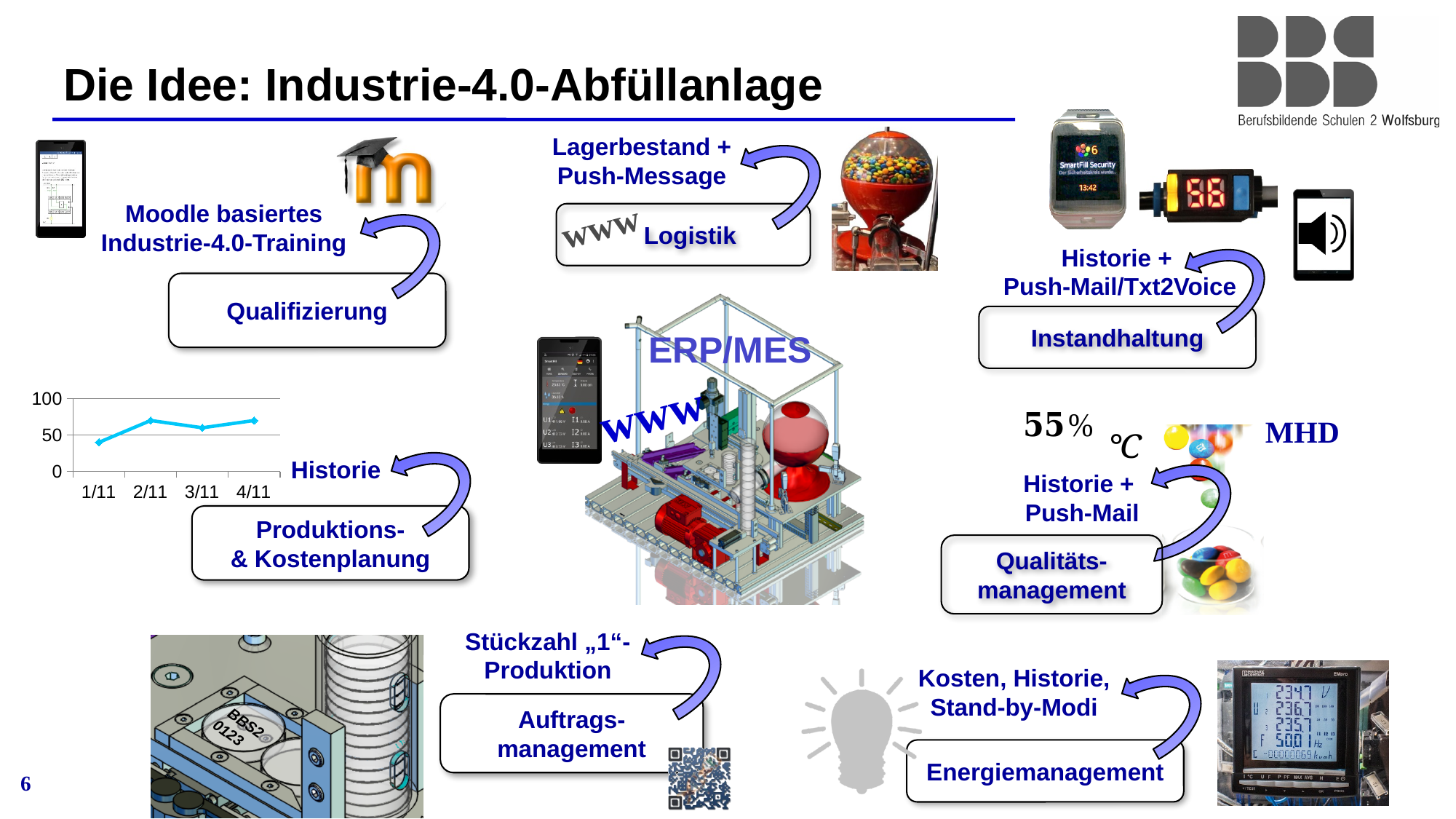
Does the line rise or fall from 1/11 to 2/11? rise Which category on the line chart has the lowest value? 1/11 Which is larger on the line chart, the value for 1/11 or the value for 4/11? 4/11 Does the line rise or fall from 2/11 to 3/11? fall What is the highest tick value shown on the y axis of the line chart? 100 What kind of chart is shown on the slide? line chart Which is larger on the line chart, the value for 1/11 or the value for 2/11? 2/11 Is the value for 2/11 greater or less than 50? greater Is the value for 4/11 greater or less than 100? less Is the value for 3/11 greater or less than 50? greater How many data points are plotted on the line chart? 4